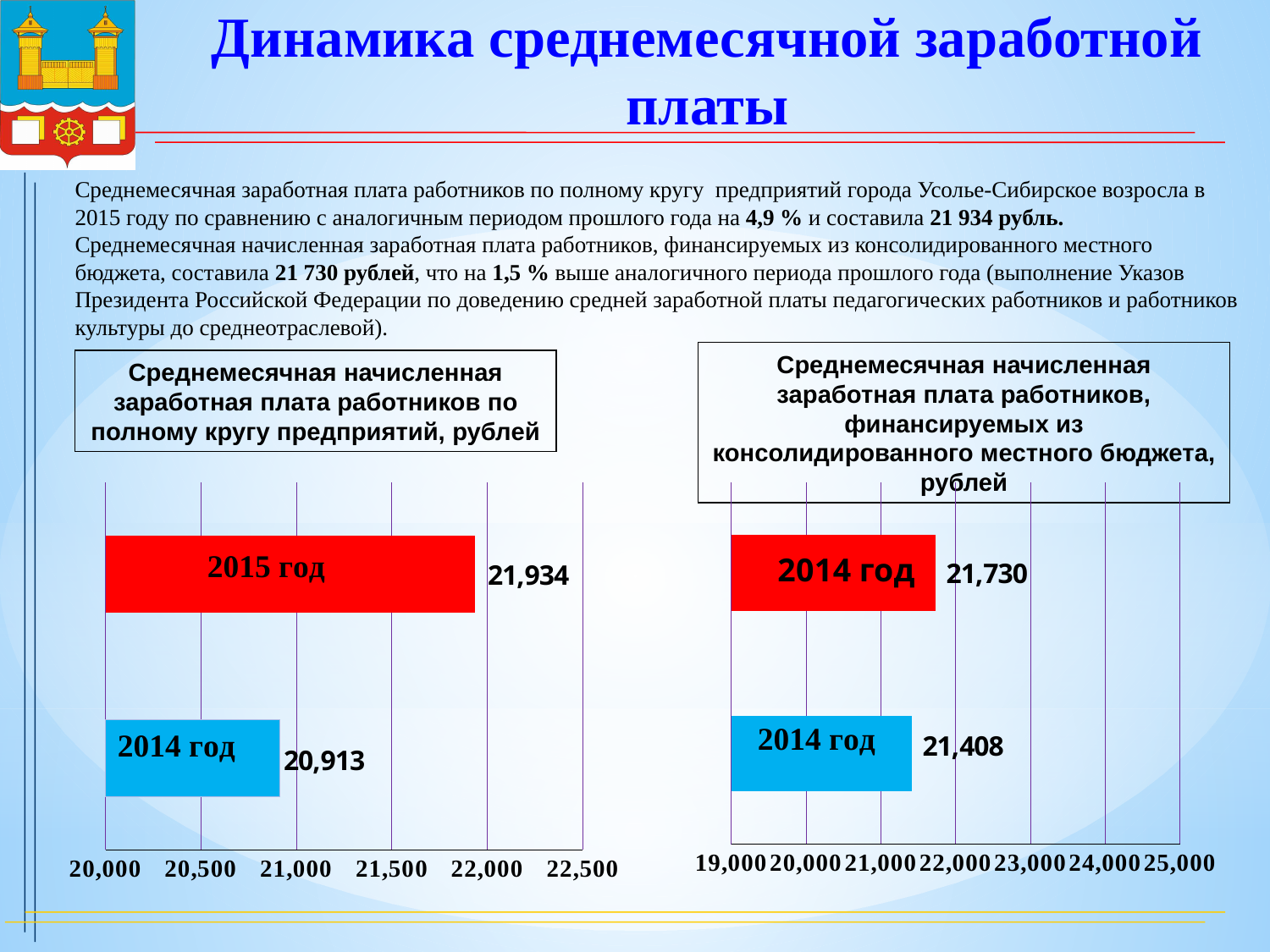
In the right chart (финансируемых из консолидированного местного бюджета), is the red bar's value greater or less than 21,000? greater In the right chart (финансируемых из консолидированного местного бюджета), what is the value of the blue (bottom) bar? 21,408 In the left chart (по полному кругу предприятий), what colour is the 2015 год bar? Red In the left chart (по полному кругу предприятий), what is the difference between the 2015 год and 2014 год values? 1,021 In the left chart (по полному кругу предприятий), which year has the higher value? 2015 год In the left chart (по полному кругу предприятий), what is the value for 2015 год? 21,934 In the right chart (финансируемых из консолидированного местного бюджета), what is the lowest value shown on the x axis? 19,000 In the left chart (по полному кругу предприятий), what is the value for 2014 год? 20,913 In the right chart (финансируемых из консолидированного местного бюджета), what is the value of the red (top) bar? 21,730 In the left chart (по полному кругу предприятий), how many bars are plotted? 2 What kind of chart is the left chart (по полному кругу предприятий)? Bar chart In the right chart (финансируемых из консолидированного местного бюджета), what is the difference between the red bar and the blue bar values? 322